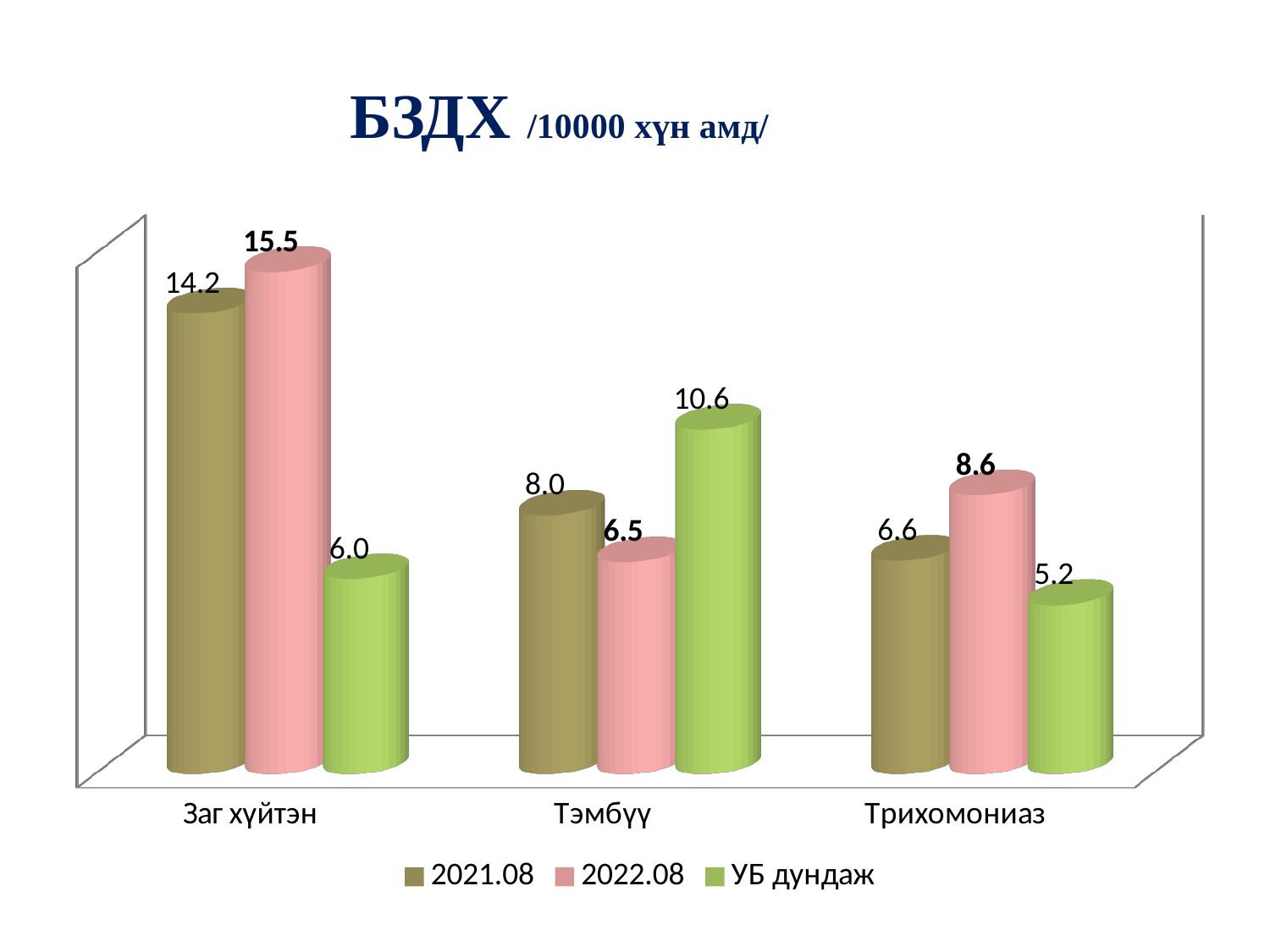
What is the title of the chart? БЗДХ /10000 хүн амд/ How many series does the legend list? 3 What is the value for Заг хүйтэн in the 2022.08 series? 15.5 How many categories are shown on the x axis? 3 What is the value for Тэмбүү in the УБ дундаж series? 10.6 What is the difference between the 2022.08 and 2021.08 values for Заг хүйтэн? 1.3 Which category has the lowest value in the УБ дундаж series? Трихомониаз What is the value for Трихомониаз in the 2021.08 series? 6.6 Which is larger for Тэмбүү: the 2021.08 value or the 2022.08 value? 2021.08 Which category has the highest value in the 2021.08 series? Заг хүйтэн What kind of chart is shown on the slide? Bar chart What is the difference between the УБ дундаж values for Тэмбүү and Трихомониаз? 5.4